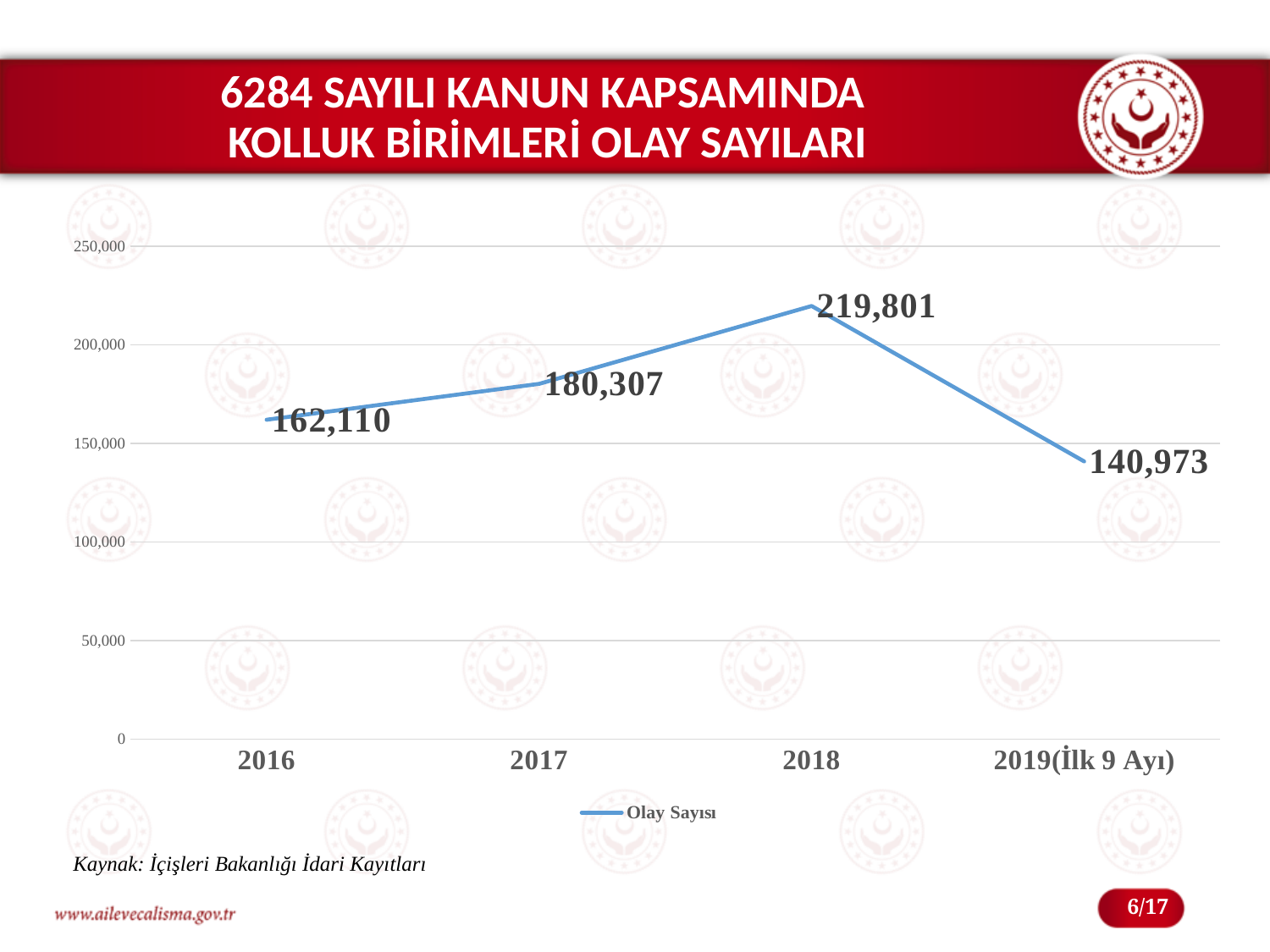
What kind of chart is shown on the slide? line chart What is the difference between the values for 2018 and 2017? 39,494 What is the value for 2019(İlk 9 Ayı)? 140,973 Is the value for 2018 greater or less than 200,000? greater Which is larger, the value for 2017 or the value for 2016? 2017 How many series does the legend list? 1 What is the value for 2016? 162,110 Which year has the highest value? 2018 How many data points are plotted on the chart? 4 What is the name of the series shown in the legend? Olay Sayısı What is the value for 2018? 219,801 Which category has the lowest value? 2019(İlk 9 Ayı)